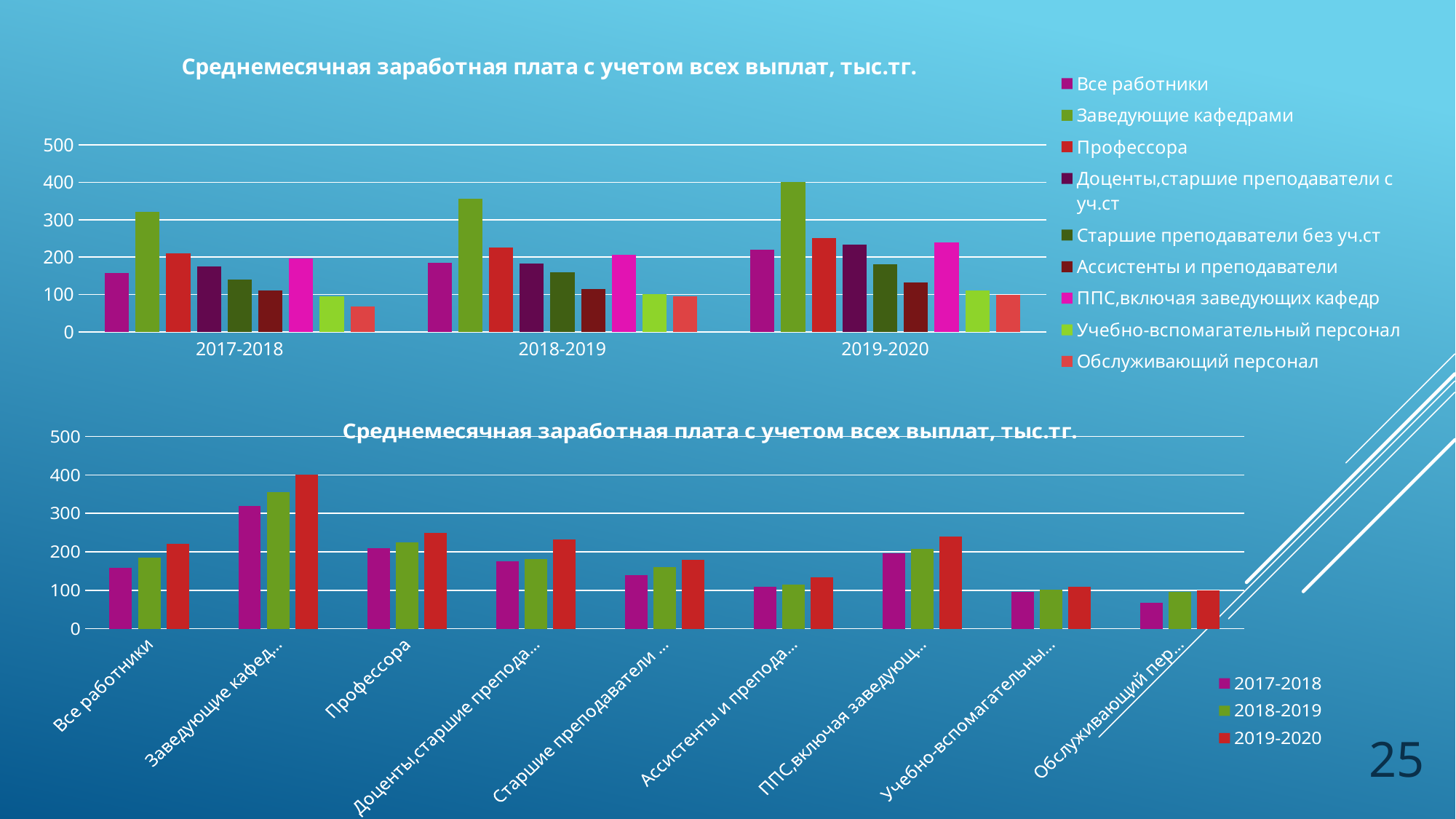
In the top chart, which series has the highest value for 2017-2018? Заведующие кафедрами In the top chart, for 2018-2019, which is larger: Профессора or Все работники? Профессора What kind of chart is the top chart on the slide? bar chart In the bottom chart, is the 2017-2018 value for Обслуживающий персонал greater or less than 100? less In the bottom chart, do the values for Все работники rise or fall from 2017-2018 to 2019-2020? rise What is the title of the top chart? Среднемесячная заработная плата с учетом всех выплат, тыс.тг. In the top chart, is the value for Заведующие кафедрами in 2019-2020 greater or less than 300? greater How many series does the legend of the bottom chart list? 3 In the bottom chart, which category has the highest value for 2019-2020? Заведующие кафедрами In the top chart, which series has the lowest value for 2017-2018? Обслуживающий персонал How many series does the legend of the top chart list? 9 How many academic-year categories are shown on the x axis of the top chart? 3